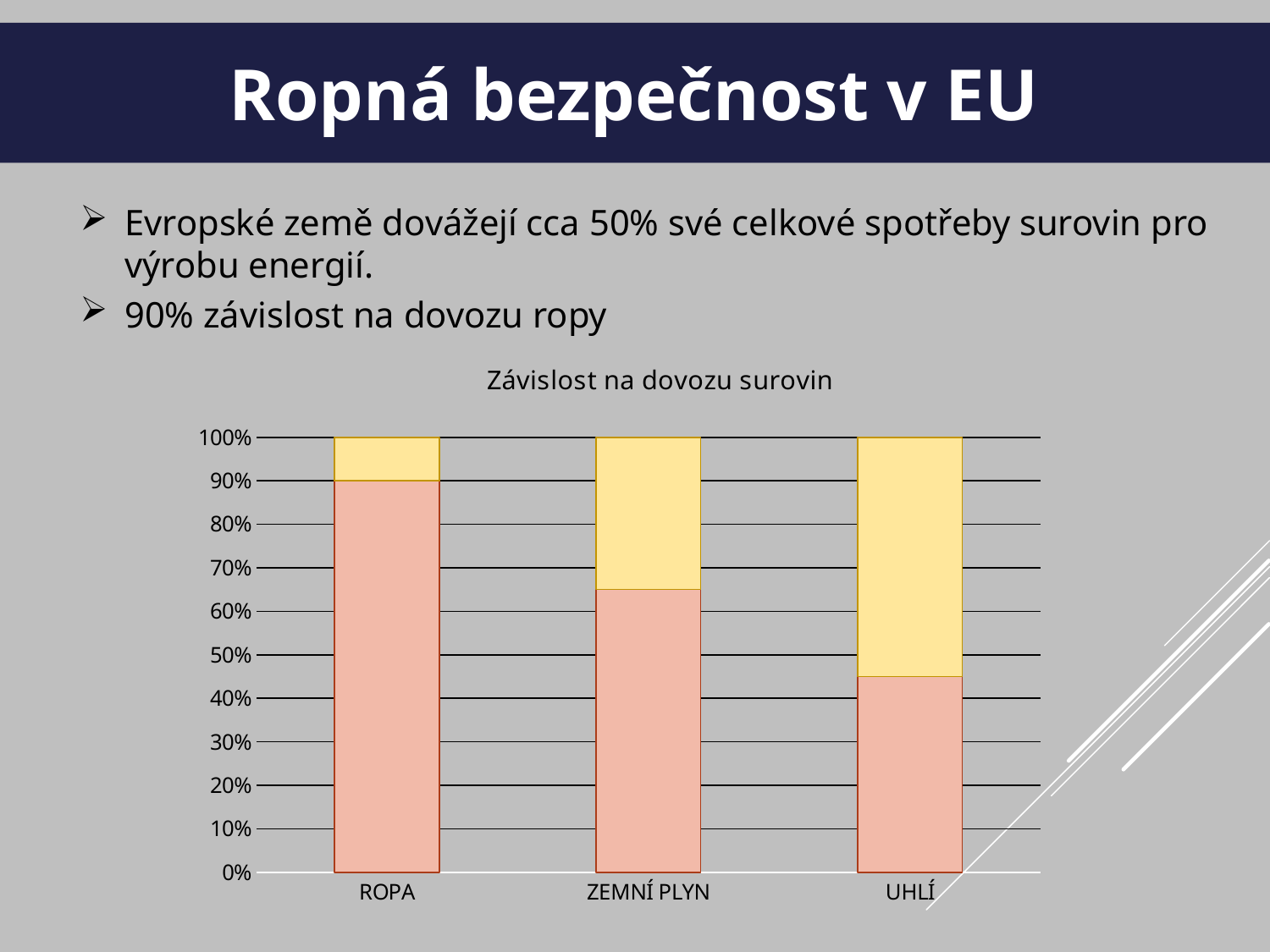
Which category has the largest lower (pink) segment? ROPA How many categories are shown on the x axis of the chart? 3 What is the total height of each stacked bar in the chart? 100% Is the upper (yellow) segment for ROPA greater or less than 20%? less Which has a larger lower (pink) segment, ZEMNÍ PLYN or UHLÍ? ZEMNÍ PLYN Is the lower (pink) segment for ZEMNÍ PLYN greater or less than 60%? greater Which category has the smallest lower (pink) segment? UHLÍ What kind of chart is shown on the slide? stacked bar chart Does the lower (pink) segment rise or fall from ROPA to UHLÍ along the x axis? fall Is the lower (pink) segment for UHLÍ greater or less than 50%? less What is the value of the lower (pink) segment for ROPA? 90% What is the title of the chart? Závislost na dovozu surovin